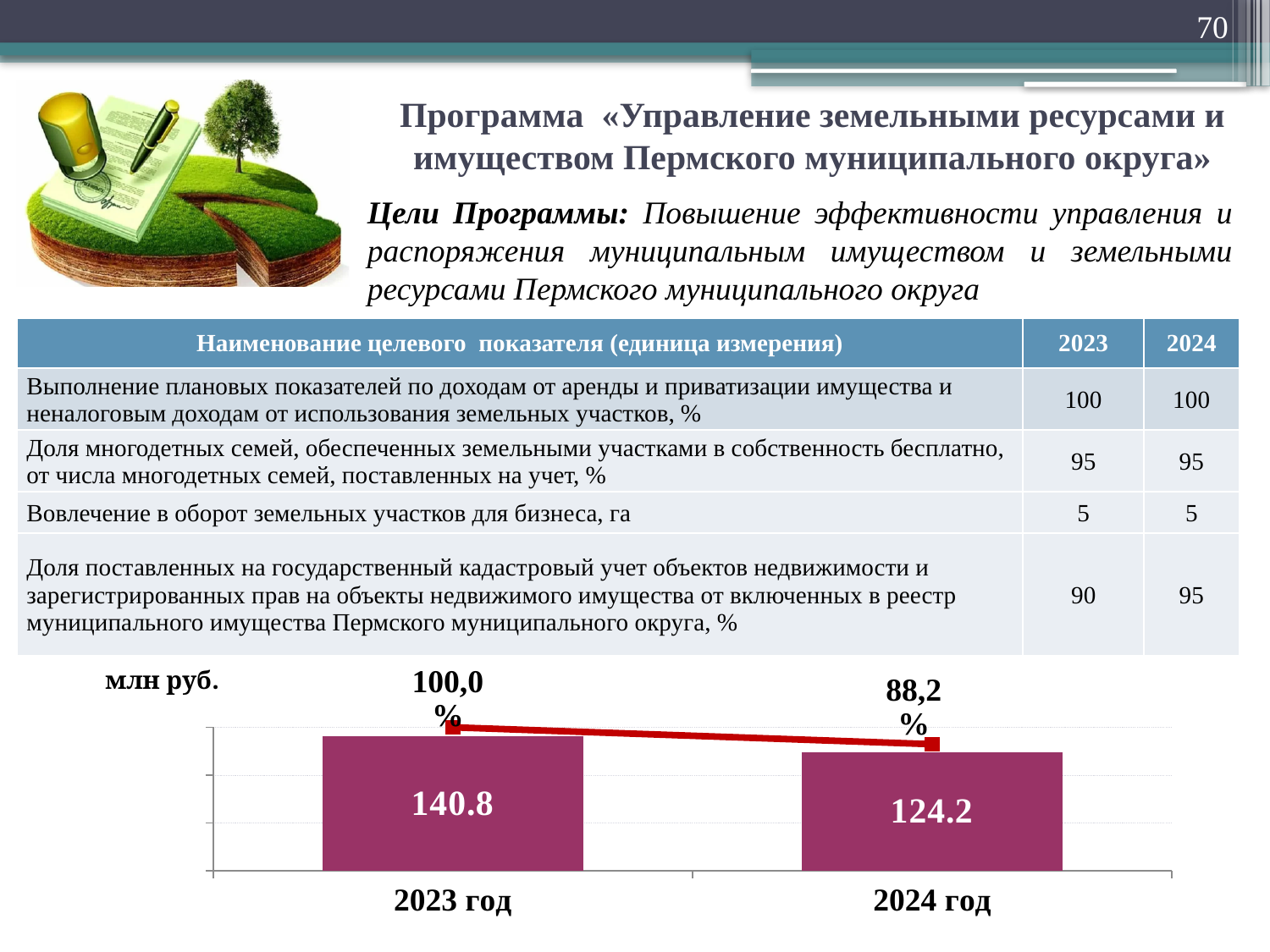
Which year has the higher bar value? 2023 год What is the difference between the bar values for 2023 год and 2024 год? 16.6 What kind of chart is shown at the bottom of the slide? combination bar and line chart Which year has the lower bar value? 2024 год Is the bar value for 2023 год larger or smaller than the bar value for 2024 год? larger How many bars are plotted in the chart? 2 What percentage label is shown on the line for 2023 год? 100,0 % Do the bar values rise or fall from 2023 год to 2024 год? fall What percentage label is shown on the line for 2024 год? 88,2 % What unit of measurement is indicated for the bar chart? млн руб. What is the value of the bar for 2023 год? 140.8 What is the value of the bar for 2024 год? 124.2